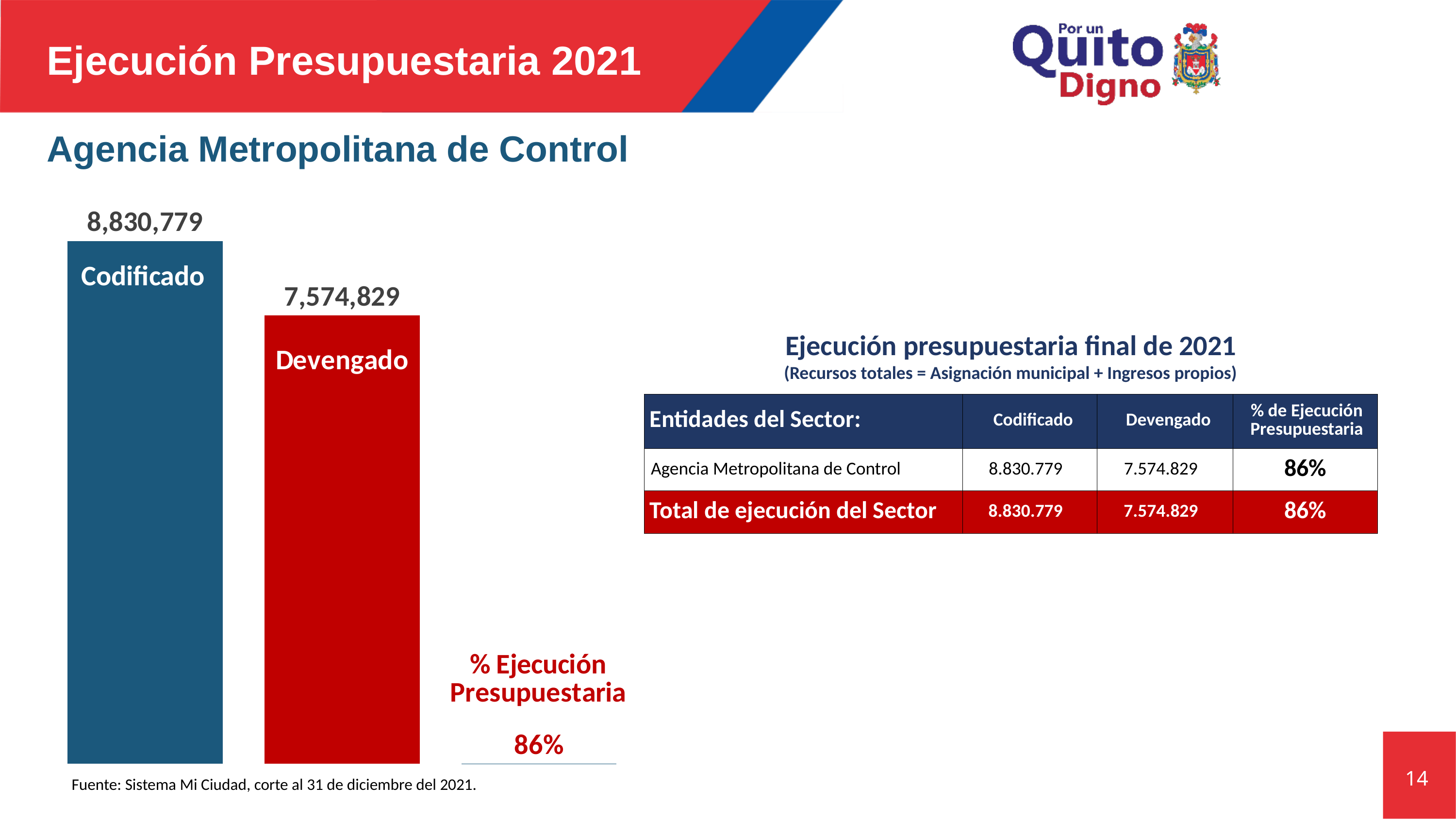
What colour is the Devengado bar? Red What is the % Ejecución Presupuestaria shown next to the bars? 86% What colour is the Codificado bar? Blue What is the value of the Devengado bar? 7,574,829 Which bar is higher, Codificado or Devengado? Codificado What is the difference between the Codificado and Devengado values? 1,255,950 What kind of chart is shown on the slide? Bar chart How many bars are shown in the chart? 2 Which bar has the lowest value? Devengado What is the value of the Codificado bar? 8,830,779 Do the values fall or rise from the Codificado bar to the Devengado bar? Fall